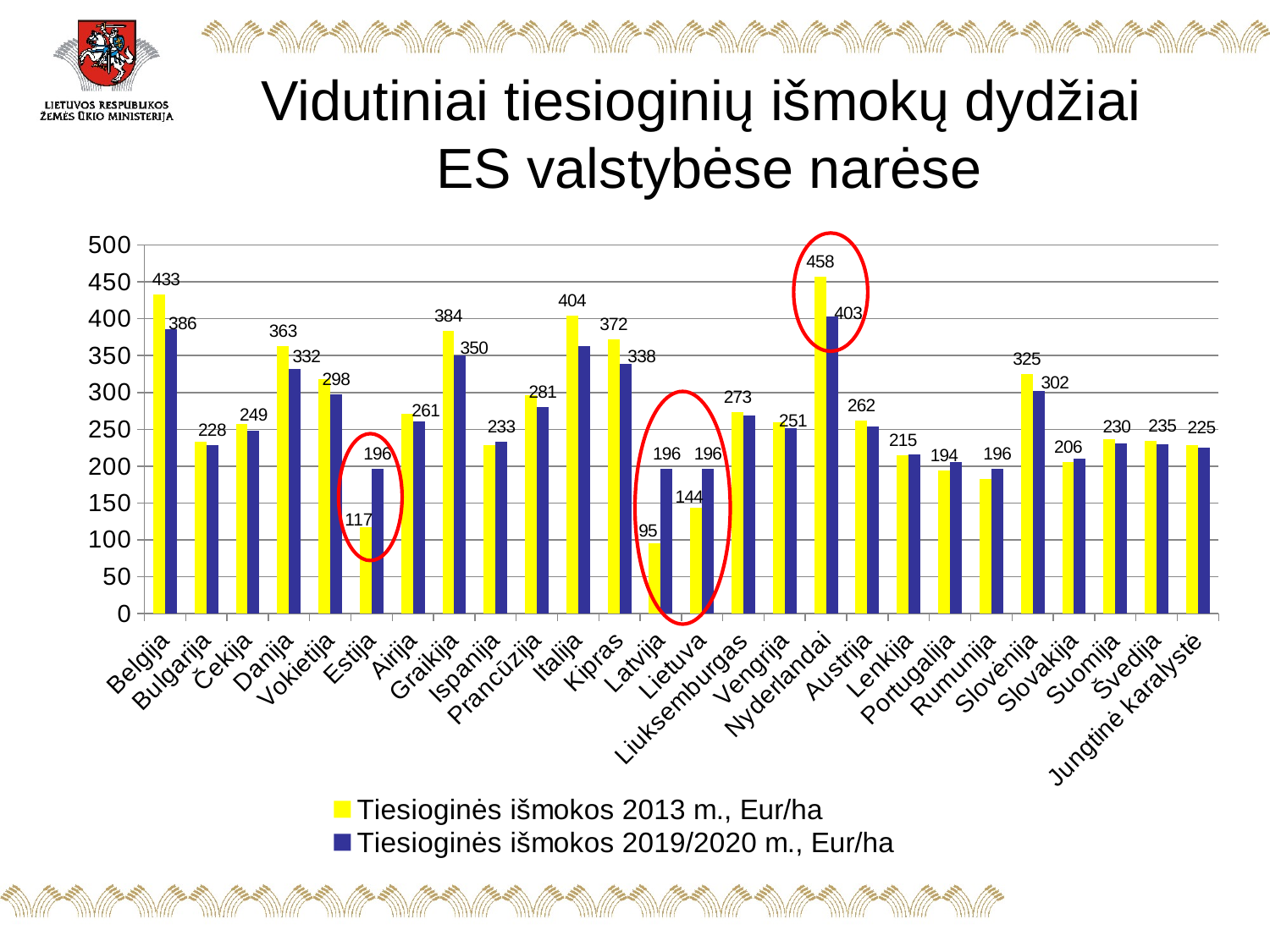
What kind of chart is shown on the slide? Bar chart Which is larger for Lietuva: the 2013 value or the 2019/2020 value? 2019/2020 value What is the value for Nyderlandai in the series Tiesioginės išmokos 2019/2020 m., Eur/ha? 403 Which country has the highest value in the series Tiesioginės išmokos 2013 m., Eur/ha? Nyderlandai What is the value for Belgija in the series Tiesioginės išmokos 2013 m., Eur/ha? 433 Which country has the lowest value in the series Tiesioginės išmokos 2013 m., Eur/ha? Latvija What is the difference between the 2013 and 2019/2020 values for Estija? 79 How many series does the legend list? 2 How many countries are shown on the x axis? 26 What is the value for Latvija in the series Tiesioginės išmokos 2013 m., Eur/ha? 95 What is the difference between the 2013 and 2019/2020 values for Nyderlandai? 55 Is the value for Italija in the series Tiesioginės išmokos 2019/2020 m., Eur/ha greater or less than 350? greater